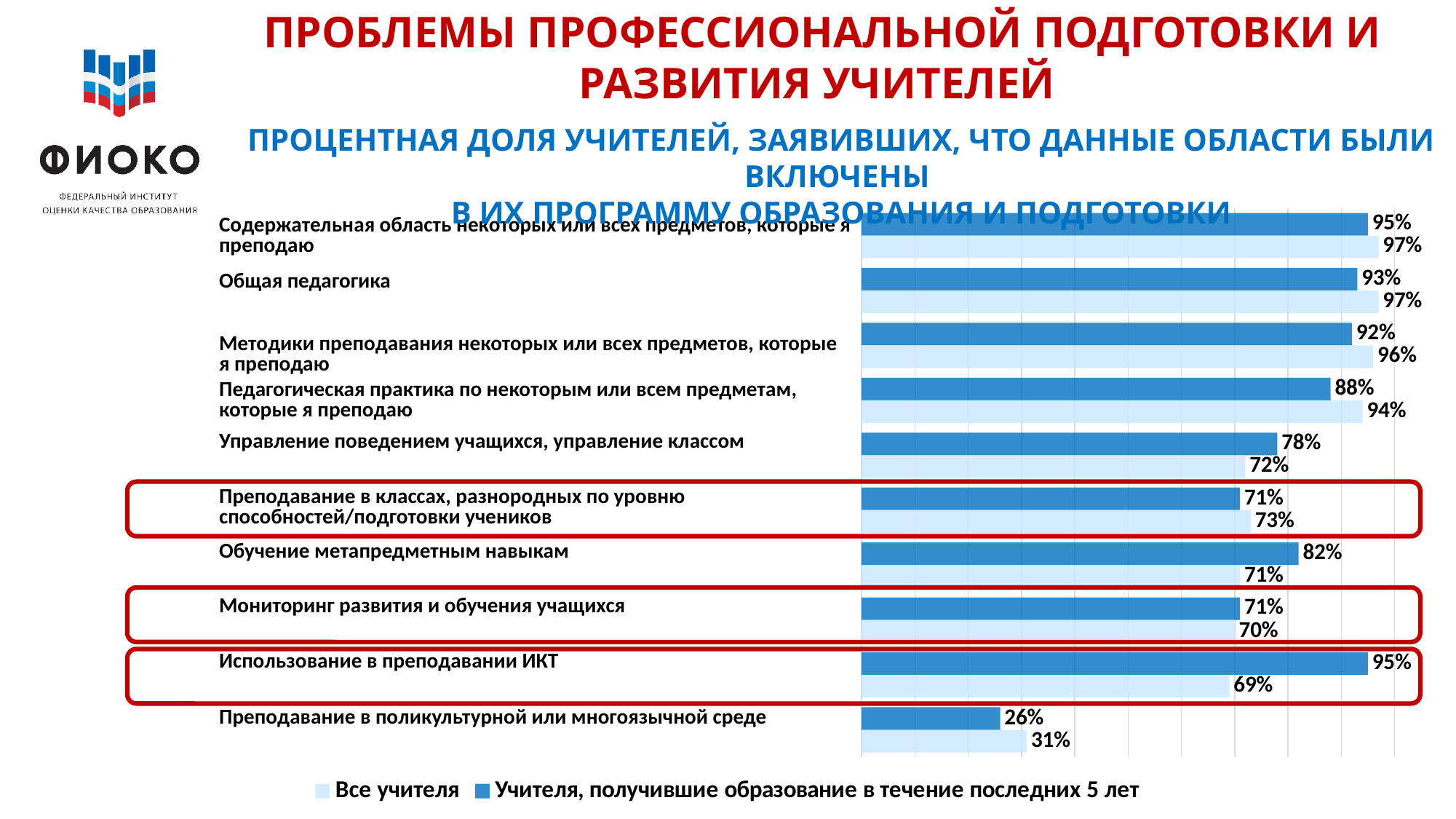
In the category "Управление поведением учащихся, управление классом", which series has the larger value? Учителя, получившие образование в течение последних 5 лет How many categories are plotted in the chart? 10 What is the value for "Все учителя" in the category "Общая педагогика"? 97% What is the value for "Учителя, получившие образование в течение последних 5 лет" in the category "Использование в преподавании ИКТ"? 95% What type of chart is shown on the slide? Bar chart In the category "Педагогическая практика по некоторым или всем предметам, которые я преподаю", which series has the larger value? Все учителя Which category has the lowest value for "Все учителя"? Преподавание в поликультурной или многоязычной среде How many series does the legend list? 2 What is the difference between the two series in the category "Обучение метапредметным навыкам"? 11% What is the value for "Все учителя" in the category "Преподавание в поликультурной или многоязычной среде"? 31% Which series is shown in dark blue in the legend? Учителя, получившие образование в течение последних 5 лет What is the difference between the two series in the category "Использование в преподавании ИКТ"? 26%